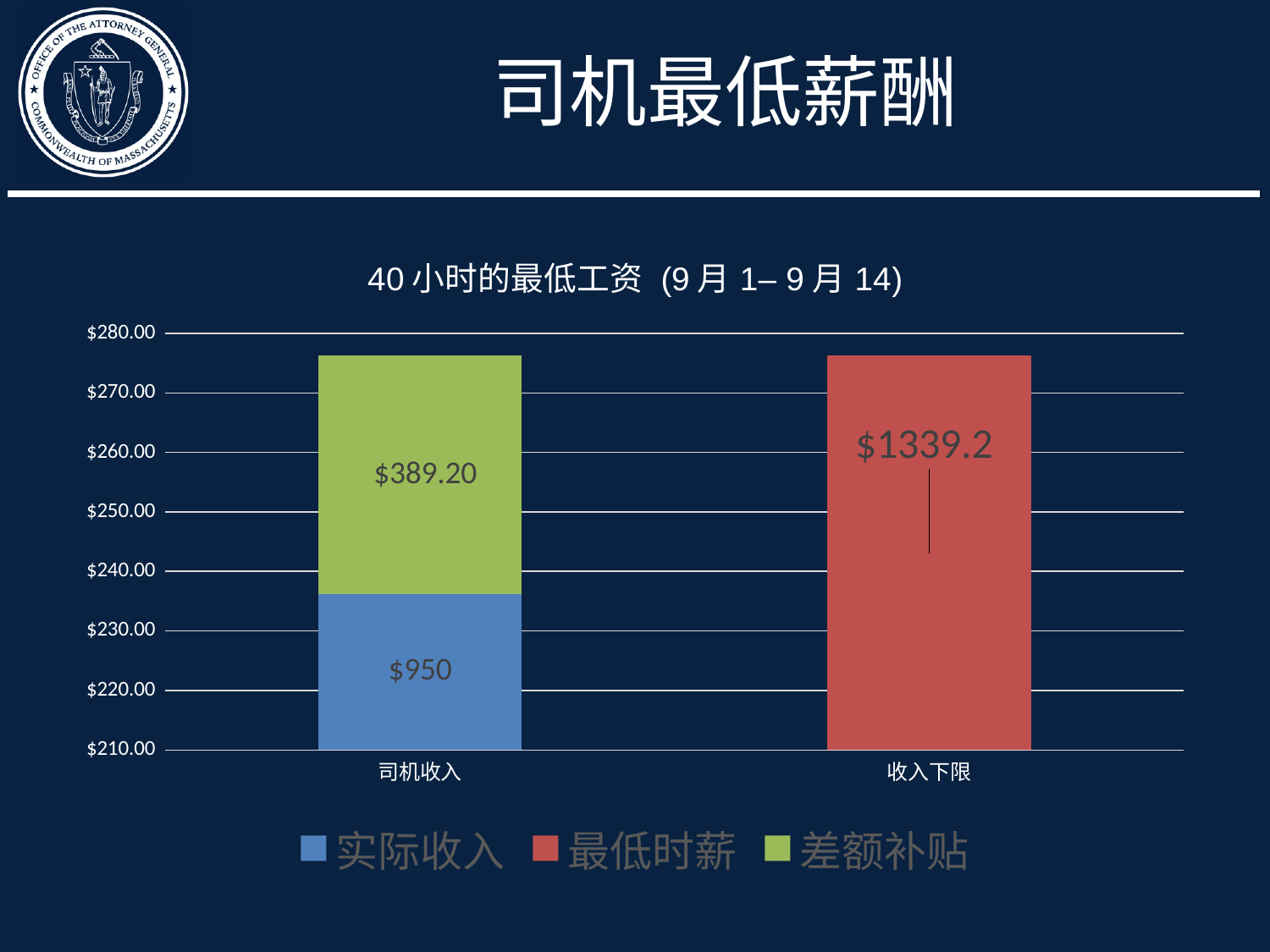
Is the top of the 实际收入 segment for 司机收入 greater or less than $230.00 on the axis? greater Which is larger for 司机收入: the 实际收入 segment or the 差额补贴 segment? 实际收入 What kind of chart is shown on the slide? Stacked bar chart What is the value of the 差额补贴 segment for 司机收入? $389.20 Which legend entry is shown in red? 最低时薪 What is the difference between the 实际收入 segment ($950) and the 差额补贴 segment ($389.20) for 司机收入? $560.80 How many series does the legend list? 3 How many categories are shown on the x axis? 2 Is the top of the 收入下限 bar greater or less than $270.00 on the axis? greater What is the total of the stacked 司机收入 bar ($950 plus $389.20)? $1339.20 What is the value labelled on the 收入下限 bar? $1339.2 What is the value of the 实际收入 segment for 司机收入? $950